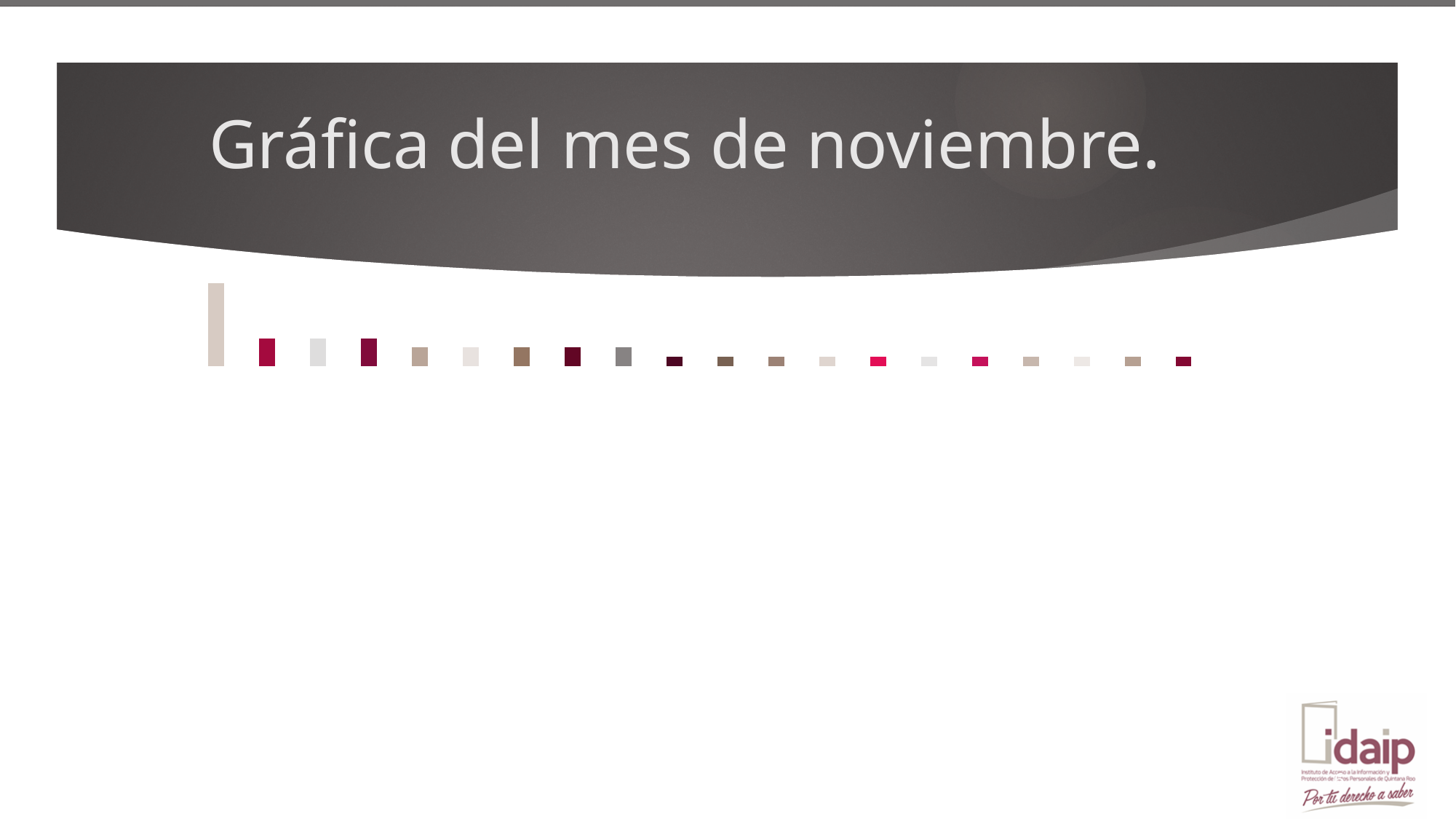
Does the chart display a legend? No What is the title of the slide containing the chart? Gráfica del mes de noviembre. Which bar in the chart is the tallest? the first (leftmost) bar What kind of chart is shown on the slide? bar chart How many bars does the chart contain? 20